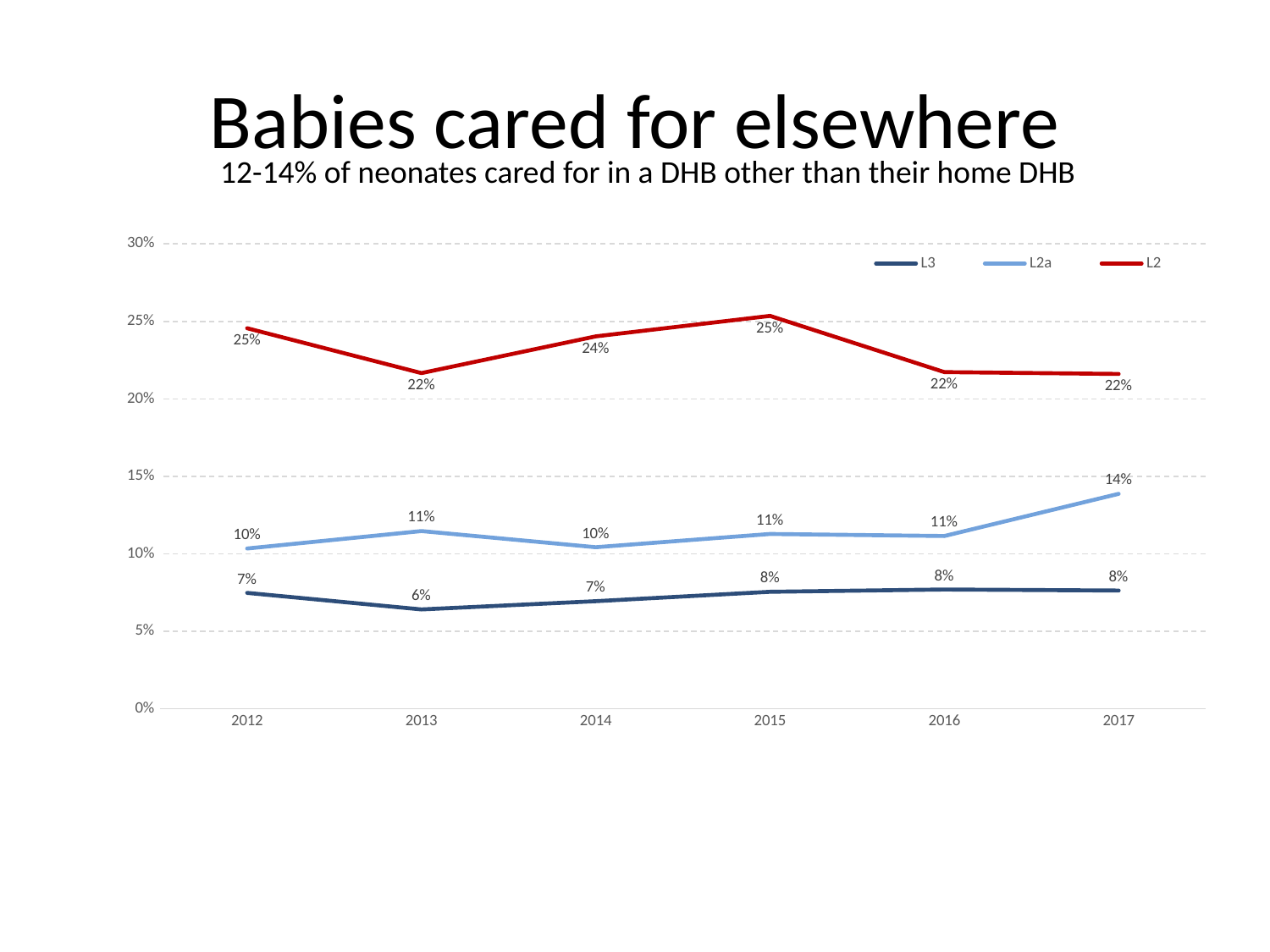
Which series is drawn in red? L2 What is the value for L2a in 2017? 14% In which year is the L2a series at its highest? 2017 How many series does the legend list? 3 What is the difference between the L2 value and the L3 value in 2012? 18% How many years are shown on the x axis? 6 In which year is the L3 series at its lowest? 2013 What is the value for L2 in 2014? 24% What is the value for L3 in 2013? 6% What kind of chart is shown on the slide? line chart Is the value for L2 in 2013 greater or less than 20%? greater Which is larger in 2015: the L2a value or the L3 value? L2a